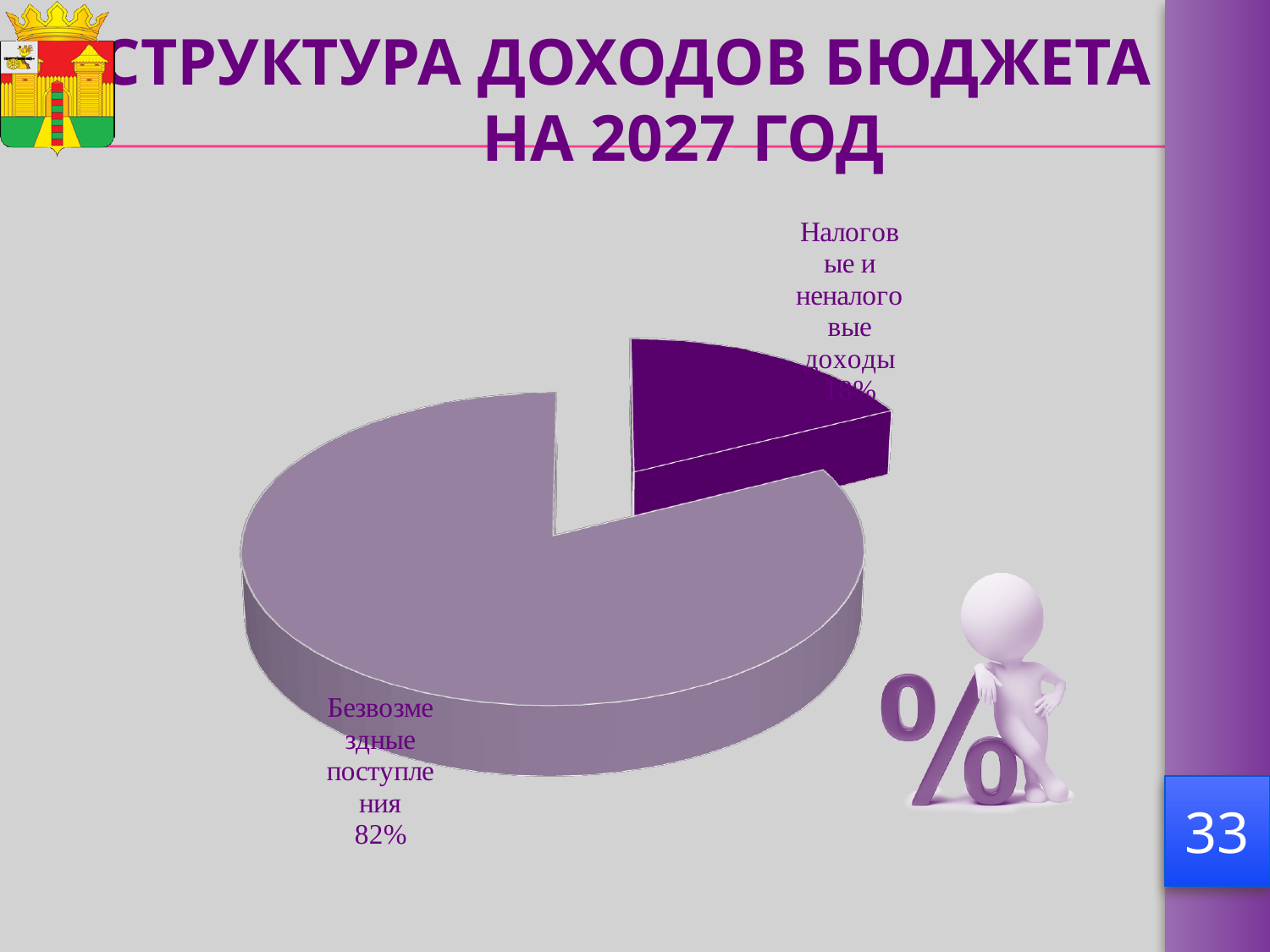
By how many percentage points does 'Безвозмездные поступления' exceed 'Налоговые и неналоговые доходы'? 64 percentage points What is the title of the slide containing the pie chart? СТРУКТУРА ДОХОДОВ БЮДЖЕТА НА 2027 ГОД How many slices does the pie chart have? 2 What kind of chart is shown on the slide? pie chart Which slice is shown in the darker purple colour? Налоговые и неналоговые доходы Which category has the largest share of the pie? Безвозмездные поступления Which category has the smallest share of the pie? Налоговые и неналоговые доходы Which is larger: 'Безвозмездные поступления' or 'Налоговые и неналоговые доходы'? Безвозмездные поступления What share of the budget revenue is 'Безвозмездные поступления'? 82% What share of the budget revenue is 'Налоговые и неналоговые доходы'? 18%